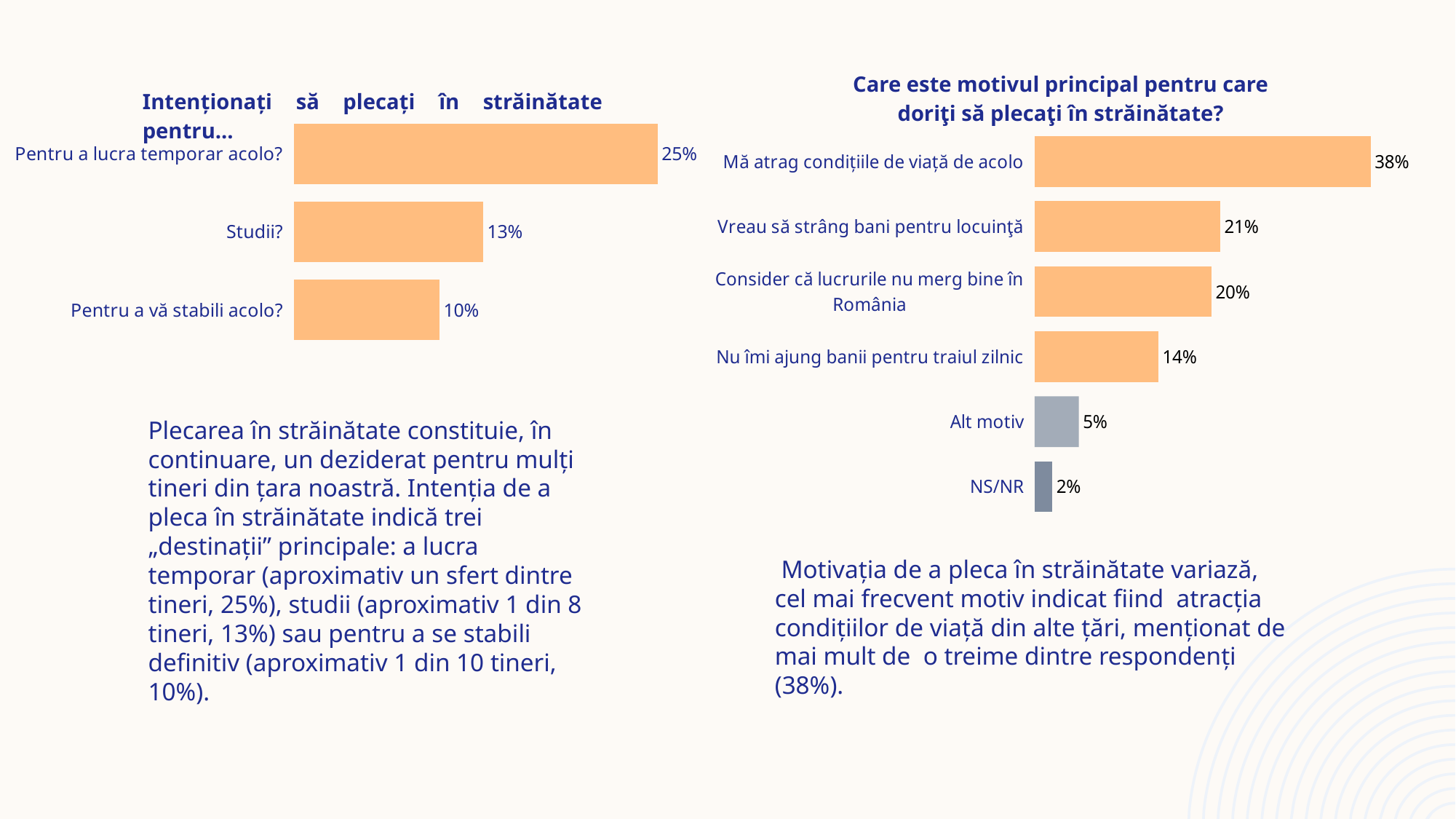
In the left chart ("Intenționați să plecați în străinătate pentru..."), which category has the highest value? Pentru a lucra temporar acolo? In the right chart ("Care este motivul principal pentru care doriţi să plecaţi în străinătate?"), what is the difference between "Mă atrag condițiile de viață de acolo" and "Vreau să strâng bani pentru locuinţă"? 17% In the left chart ("Intenționați să plecați în străinătate pentru..."), what is the difference between "Pentru a lucra temporar acolo?" and "Pentru a vă stabili acolo?"? 15% In the right chart ("Care este motivul principal pentru care doriţi să plecaţi în străinătate?"), which category has the highest value? Mă atrag condițiile de viață de acolo In the left chart ("Intenționați să plecați în străinătate pentru..."), what is the value for "Studii?"? 13% In the right chart ("Care este motivul principal pentru care doriţi să plecaţi în străinătate?"), which category has the lowest value? NS/NR In the right chart ("Care este motivul principal pentru care doriţi să plecaţi în străinătate?"), what is the value for "Consider că lucrurile nu merg bine în România"? 20% In the left chart ("Intenționați să plecați în străinătate pentru..."), how many categories are shown? 3 In the right chart ("Care este motivul principal pentru care doriţi să plecaţi în străinătate?"), which is larger: "Vreau să strâng bani pentru locuinţă" or "Alt motiv"? Vreau să strâng bani pentru locuinţă In the right chart ("Care este motivul principal pentru care doriţi să plecaţi în străinătate?"), how many categories are shown? 6 In the right chart ("Care este motivul principal pentru care doriţi să plecaţi în străinătate?"), what is the value for "Nu îmi ajung banii pentru traiul zilnic"? 14% What type of chart is the right chart ("Care este motivul principal pentru care doriţi să plecaţi în străinătate?")? Bar chart